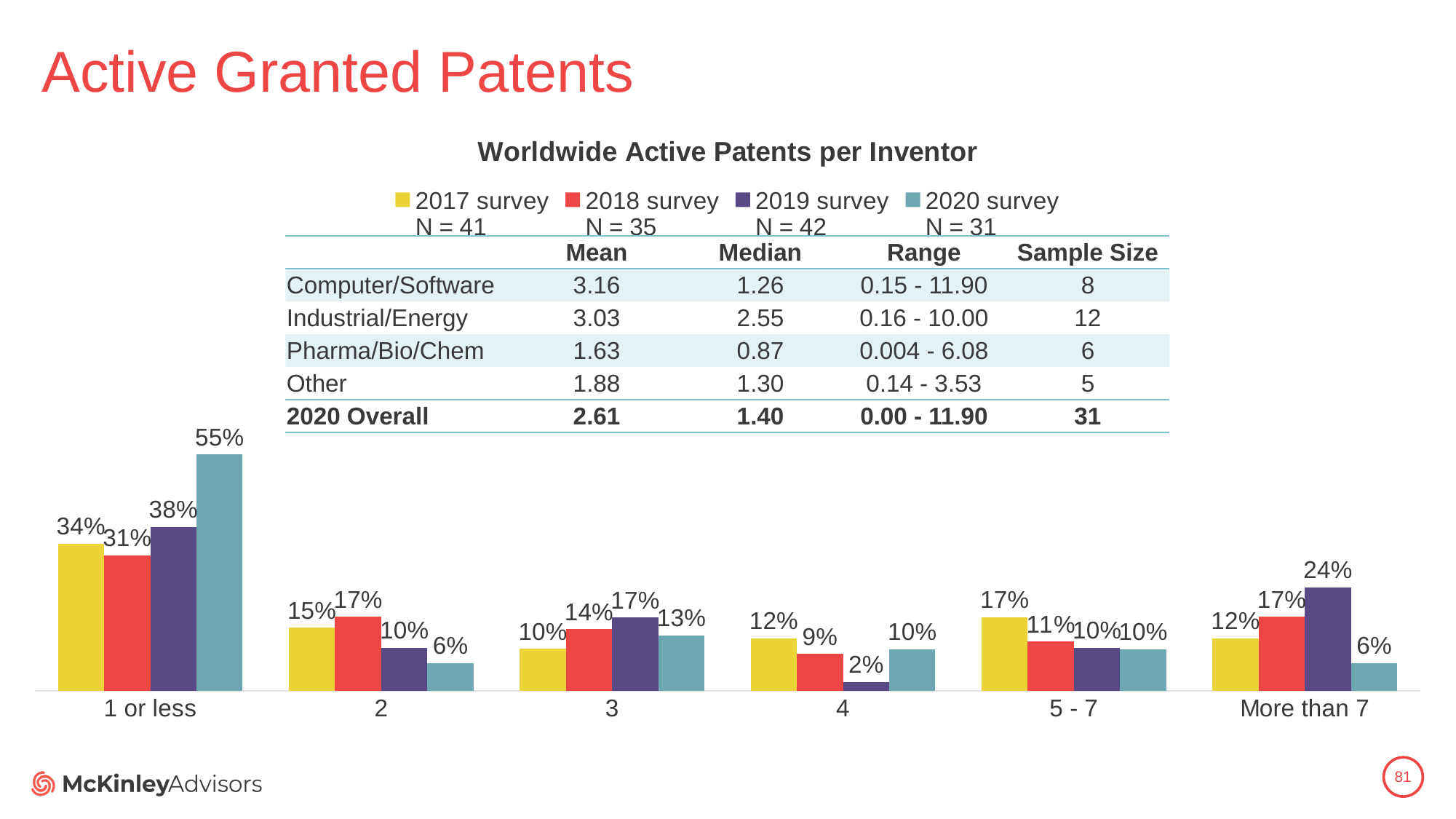
Which category has the highest value for the 2017 survey? 1 or less What is the value for the 2019 survey in the 'More than 7' category? 24% What kind of chart is shown on the slide? Bar chart What is the sample size (N) for the 2020 survey shown in the legend? N = 31 What is the value for the 2018 survey in the '3' category? 14% How many categories are shown on the x axis? 6 What is the title of the chart? Worldwide Active Patents per Inventor How many series does the legend list? 4 Which category has the lowest value for the 2019 survey? 4 What is the value for the 2020 survey in the '1 or less' category? 55% What is the difference between the 2020 survey and the 2017 survey values in the '1 or less' category? 21% Which is larger in the '2' category: the 2017 survey value or the 2018 survey value? 2018 survey